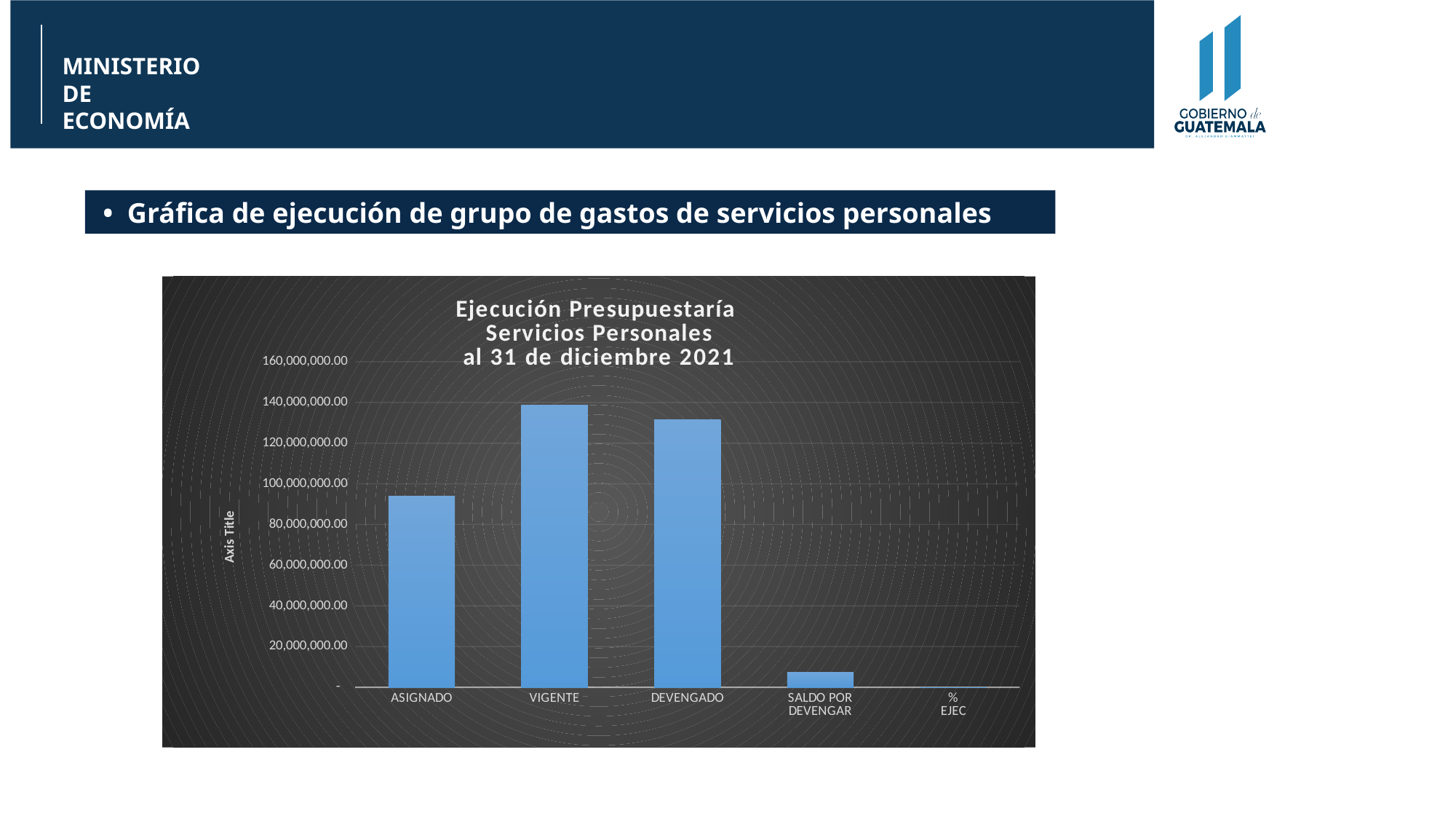
Which is larger, the value for VIGENTE or the value for ASIGNADO? VIGENTE What kind of chart is shown on the slide? bar chart Which category has the lowest value in the chart? % EJEC Which is larger, the value for DEVENGADO or the value for SALDO POR DEVENGAR? DEVENGADO Is the value for VIGENTE greater or less than 120,000,000.00? greater Which category has the highest bar in the chart? VIGENTE Is the value for SALDO POR DEVENGAR greater or less than 20,000,000.00? less Is the value for ASIGNADO greater or less than 80,000,000.00? greater How many categories are shown on the x axis of the chart? 5 What is the title of the chart? Ejecución Presupuestaría Servicios Personales al 31 de diciembre 2021 What label is shown on the vertical axis of the chart? Axis Title